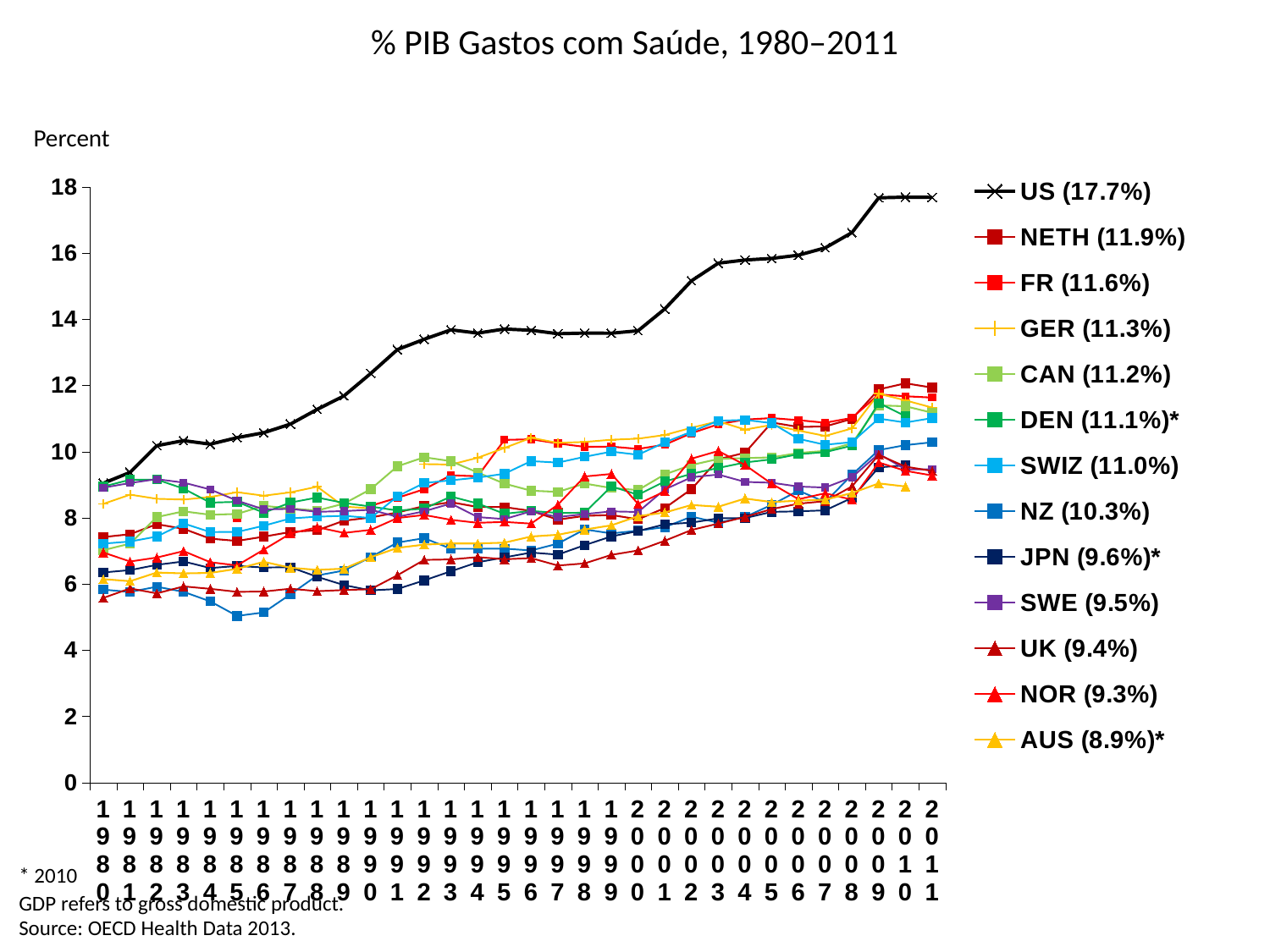
Which country has the lowest percentage shown in the legend? AUS (8.9%) What kind of chart is shown on the slide? line chart How many series does the legend list? 13 Does the US line rise or fall from 1980 to 2011? rise Is the value for US in 2011 greater or less than 16? greater What is the difference between the legend values for US and NETH? 5.8% What is the title of the chart? % PIB Gastos com Saúde, 1980–2011 Which country has the highest percentage shown in the legend? US (17.7%) How many years are plotted along the x axis? 32 What percentage is shown for NETH in the legend? 11.9% Which has the larger legend value, FR or GER? FR What percentage is shown for JPN in the legend? 9.6%